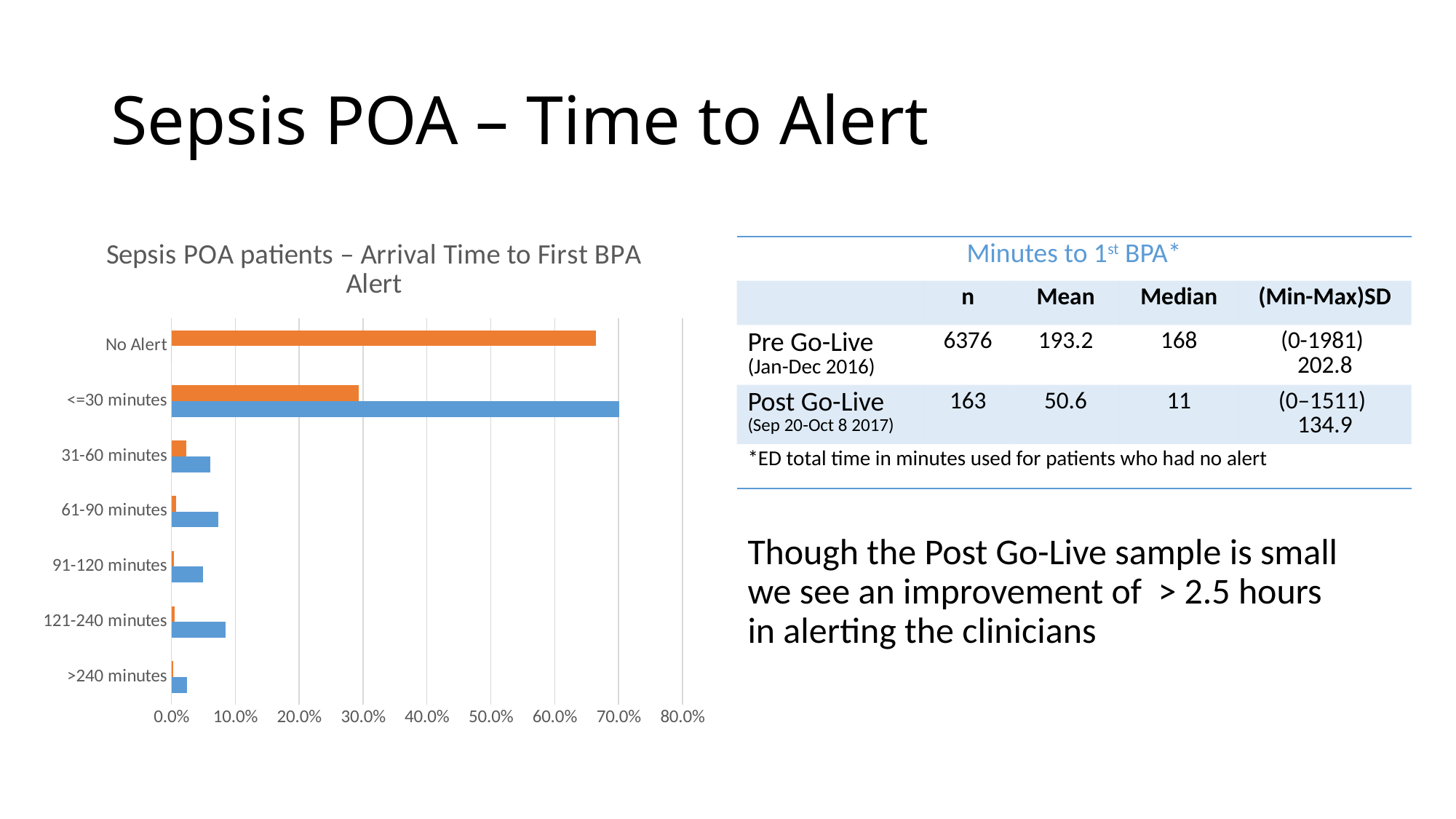
What kind of chart is shown on the slide? bar chart Is the orange bar for No Alert greater or less than 60.0%? greater How many categories are shown on the vertical axis of the chart? 7 Is the blue bar for <=30 minutes greater or less than 60.0%? greater Which category has the longest orange bar? No Alert How many differently coloured bar series are plotted in the chart? 2 Is the orange bar for <=30 minutes greater or less than 20.0%? greater What is the title of the chart? Sepsis POA patients – Arrival Time to First BPA Alert Which is larger: the blue bar for <=30 minutes or the blue bar for 31-60 minutes? <=30 minutes Which category has the longest blue bar? <=30 minutes Which is larger: the orange bar for No Alert or the orange bar for <=30 minutes? No Alert